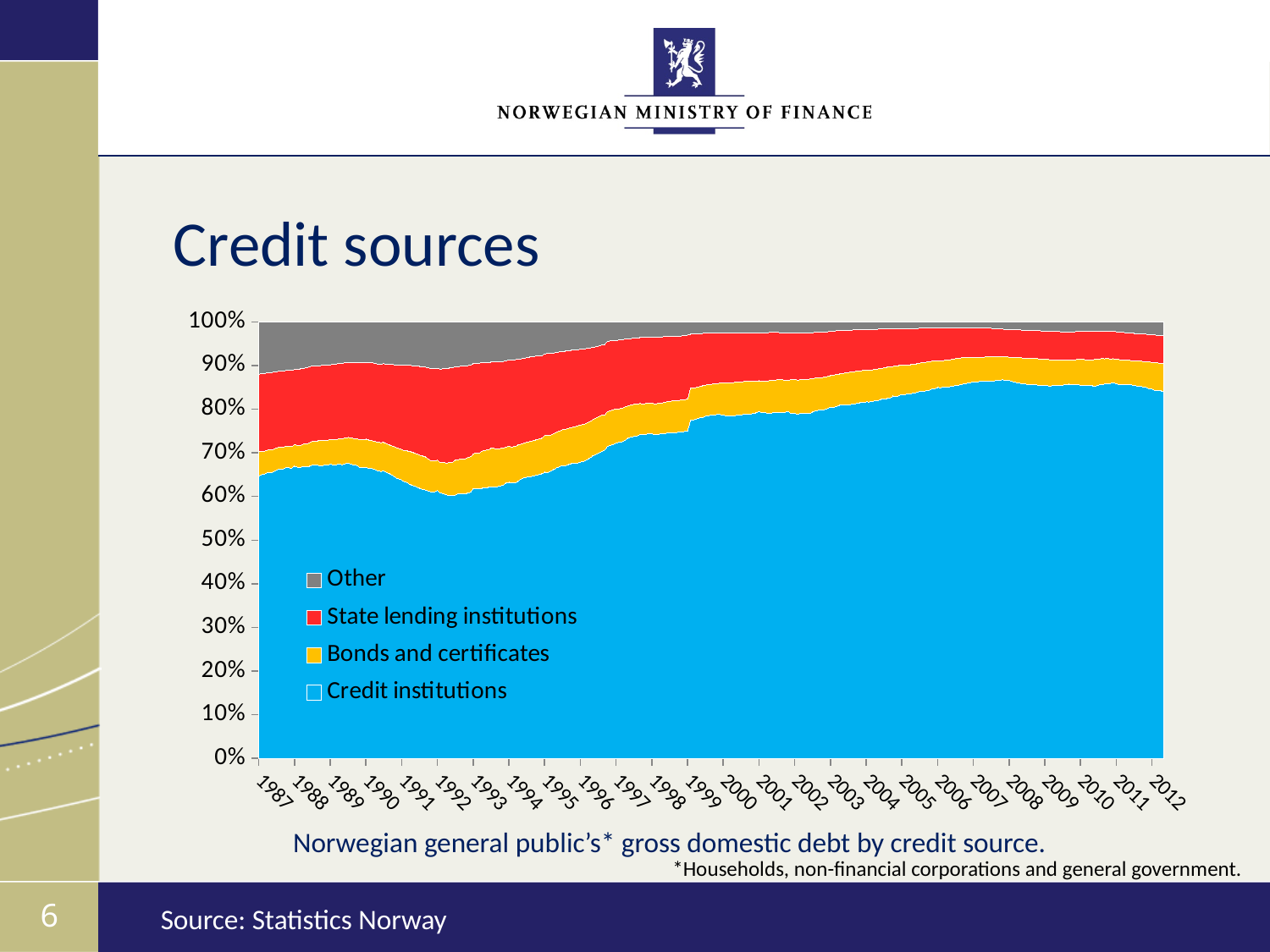
Which years does the x axis span, from first to last? 1987 to 2012 Is the share for Credit institutions in 1992 greater or less than 70%? less Is the share for Credit institutions in 1987 greater or less than 60%? greater How many years are shown along the x axis? 26 Is the share for Credit institutions larger in 1987 or in 2012? 2012 What kind of chart is shown on the slide? Stacked area chart How many series does the legend list? 4 Which series is shown in red? State lending institutions Is the share for Credit institutions in 2012 greater or less than 90%? less Does the share for Other rise or fall between 1987 and 2012? fall Does the share for Credit institutions rise or fall between 1992 and 2007? rise